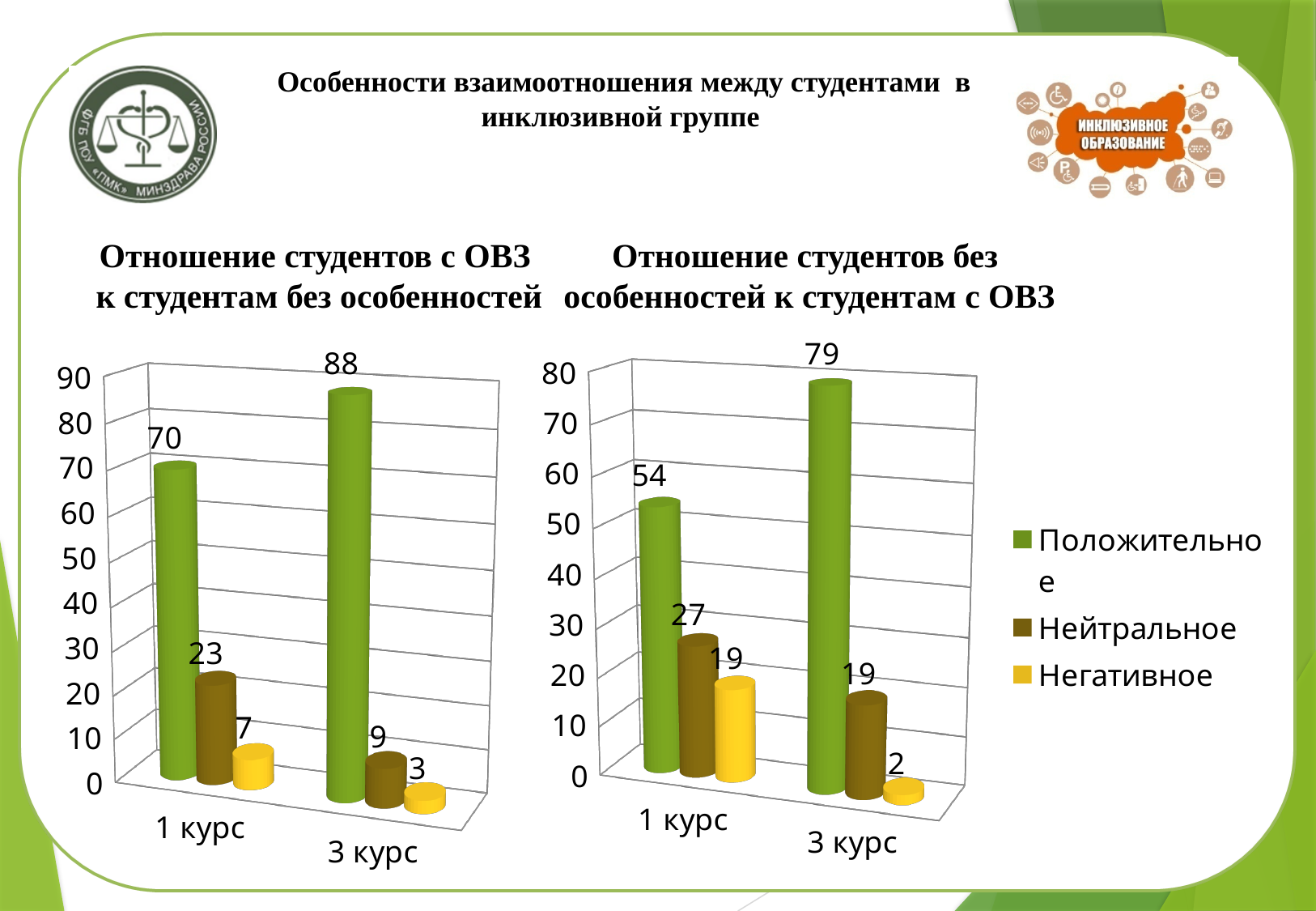
In the right chart (Отношение студентов без особенностей к студентам с ОВЗ), which series has the lowest value for 3 курс? Негативное In the left chart (Отношение студентов с ОВЗ к студентам без особенностей), by how much does Положительное for 3 курс exceed Положительное for 1 курс? 18 How many categories are shown on the x axis of the left chart (Отношение студентов с ОВЗ к студентам без особенностей)? 2 What kind of chart is the right chart (Отношение студентов без особенностей к студентам с ОВЗ)? Bar chart In the left chart (Отношение студентов с ОВЗ к студентам без особенностей), does the Негативное value fall or rise from 1 курс to 3 курс? Fall In the left chart (Отношение студентов с ОВЗ к студентам без особенностей), what is the value for Нейтральное for 3 курс? 9 In the left chart (Отношение студентов с ОВЗ к студентам без особенностей), what is the value for Положительное for 1 курс? 70 In the left chart (Отношение студентов с ОВЗ к студентам без особенностей), which is larger: Нейтральное for 1 курс or Нейтральное for 3 курс? Нейтральное for 1 курс How many series does the legend list? 3 In the right chart (Отношение студентов без особенностей к студентам с ОВЗ), what is the difference between Нейтральное for 1 курс and Нейтральное for 3 курс? 8 In the right chart (Отношение студентов без особенностей к студентам с ОВЗ), what is the value for Негативное for 1 курс? 19 In the right chart (Отношение студентов без особенностей к студентам с ОВЗ), what is the value for Положительное for 3 курс? 79